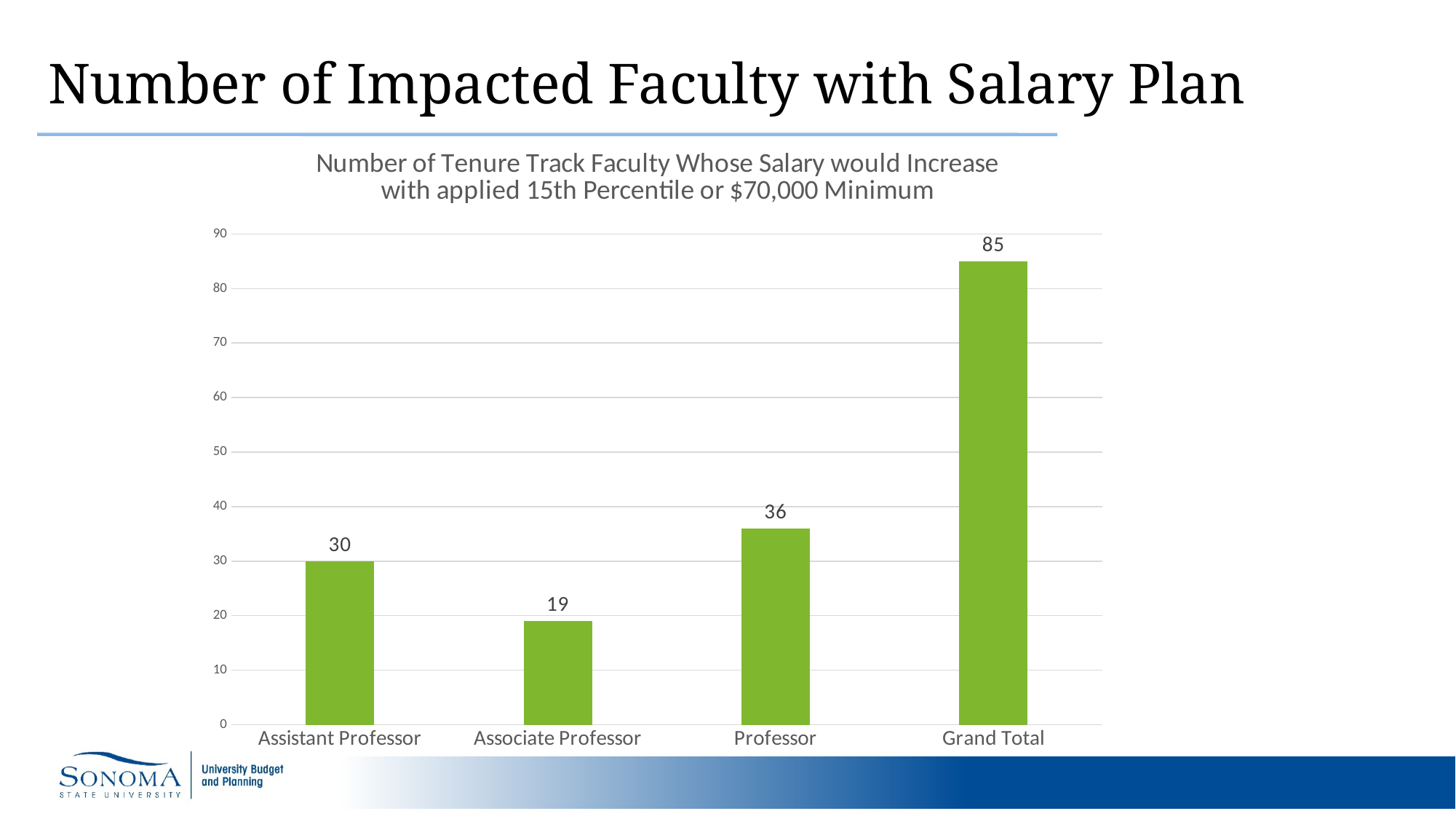
Which is larger, the value for Assistant Professor or the value for Associate Professor? Assistant Professor Is the value for Grand Total greater or less than 80? greater Which category has the highest value? Grand Total Which category has the lowest value? Associate Professor What is the value for Grand Total? 85 What is the difference between the values for Professor and Assistant Professor? 6 What is the value for Associate Professor? 19 What is the value for Assistant Professor? 30 What kind of chart is shown on the slide? bar chart What is the title of the chart? Number of Tenure Track Faculty Whose Salary would Increase with applied 15th Percentile or $70,000 Minimum How many categories are shown on the x axis? 4 What is the value for Professor? 36